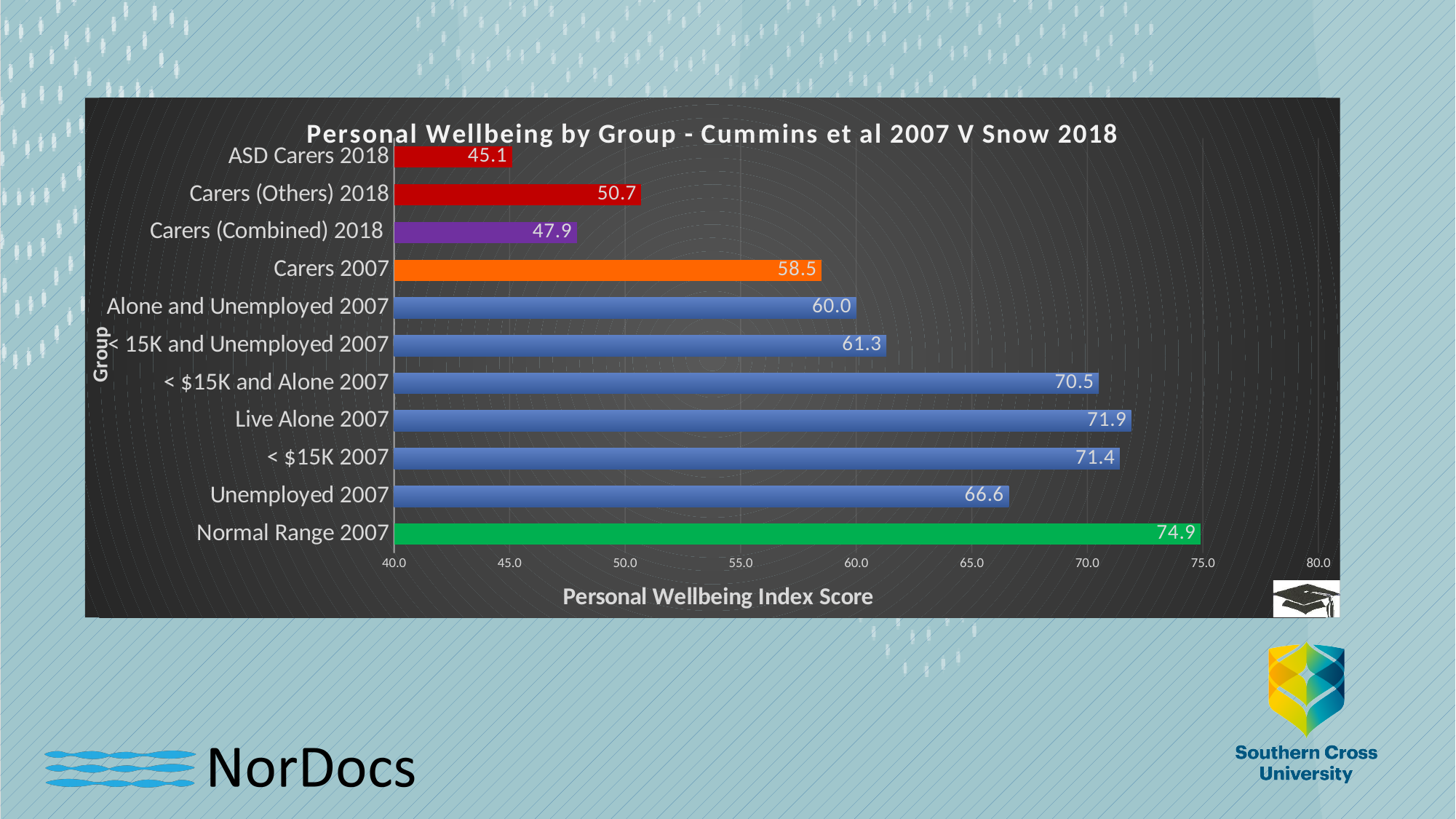
What is the Personal Wellbeing Index Score for Normal Range 2007? 74.9 What is the Personal Wellbeing Index Score for Carers 2007? 58.5 What kind of chart is shown on the slide? Bar chart What is the label of the horizontal axis? Personal Wellbeing Index Score Which group has the highest Personal Wellbeing Index Score? Normal Range 2007 Which has a higher score, Carers (Others) 2018 or Alone and Unemployed 2007? Alone and Unemployed 2007 How many groups are shown in the chart? 11 What is the title of the chart? Personal Wellbeing by Group - Cummins et al 2007 V Snow 2018 What is the difference between the scores for Carers 2007 and Carers (Combined) 2018? 10.6 Is the value for Unemployed 2007 greater or less than 65.0? greater Which group has the lowest Personal Wellbeing Index Score? ASD Carers 2018 What is the Personal Wellbeing Index Score for ASD Carers 2018? 45.1